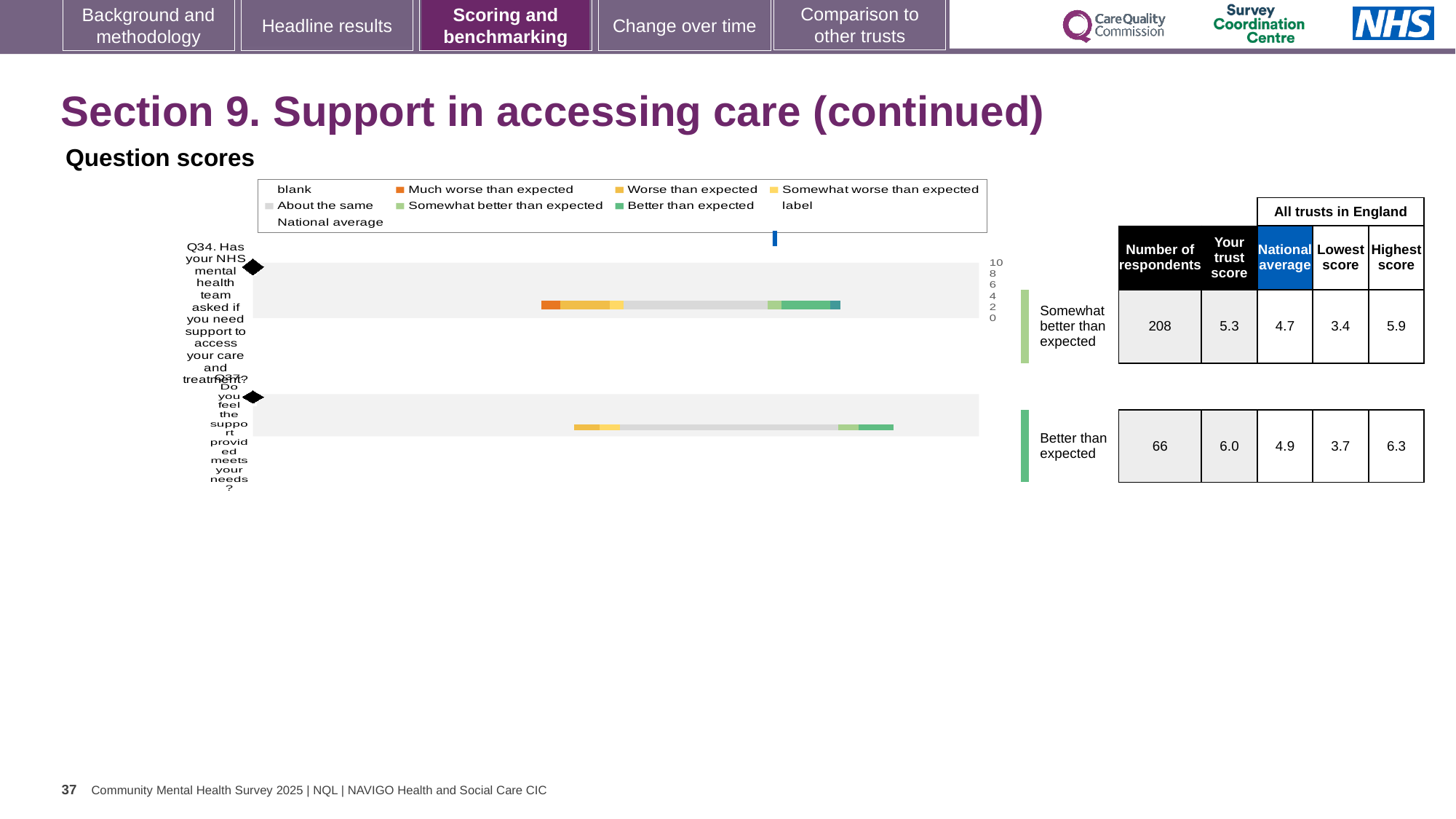
Which benchmark category is Q37 placed in? Better than expected Which question has the higher trust score, Q34 or Q37? Q37 How many questions (categories) are plotted in the question scores chart? 2 What is the trust score for Q34 (Has your NHS mental health team asked if you need support to access your care and treatment?)? 5.3 What kind of chart is used to show the question scores on this slide? bar chart What is the difference between the trust score and the national average for Q34? 0.6 What is the national average score for Q34? 4.7 What is the trust score for Q37 (Do you feel the support provided meets your needs?)? 6.0 What is the highest score among all trusts in England for Q37? 6.3 How many respondents answered Q37? 66 Is the trust score for Q34 greater or less than 4 on the chart's axis? greater What is the difference between the trust scores for Q37 and Q34? 0.7